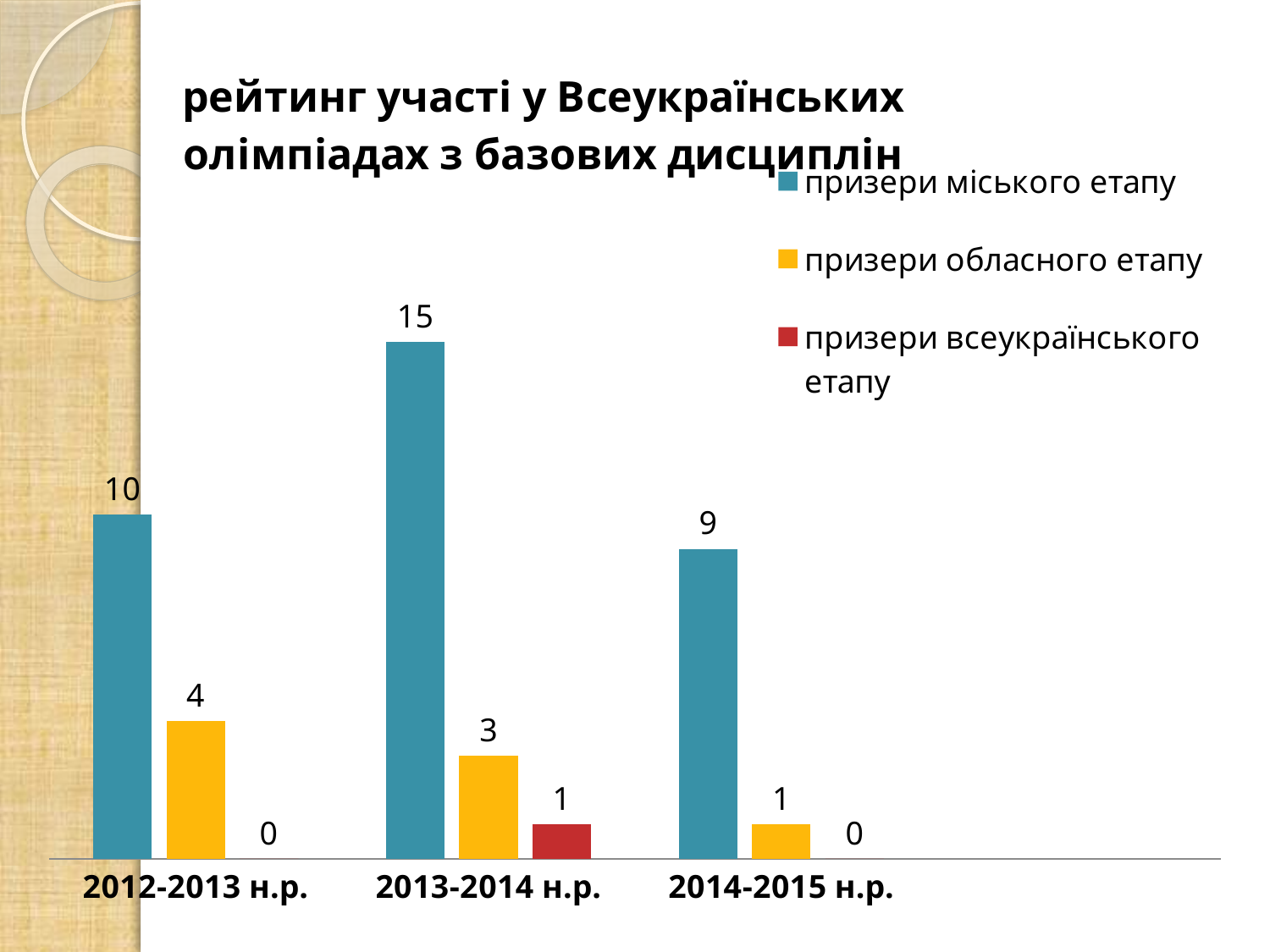
Which colour represents призери всеукраїнського етапу in the legend? red What is the value for призери обласного етапу in 2012-2013 н.р.? 4 What kind of chart is shown on the slide? bar chart How many year categories are shown on the x axis? 3 In which year is the value for призери міського етапу lowest? 2014-2015 н.р. In which year is the value for призери міського етапу highest? 2013-2014 н.р. How many series does the legend list? 3 What is the value for призери міського етапу in 2013-2014 н.р.? 15 Which is larger: призери обласного етапу in 2012-2013 н.р. or in 2013-2014 н.р.? 2012-2013 н.р. What is the value for призери міського етапу in 2014-2015 н.р.? 9 What is the difference between призери міського етапу in 2013-2014 н.р. and in 2012-2013 н.р.? 5 What is the value for призери всеукраїнського етапу in 2013-2014 н.р.? 1